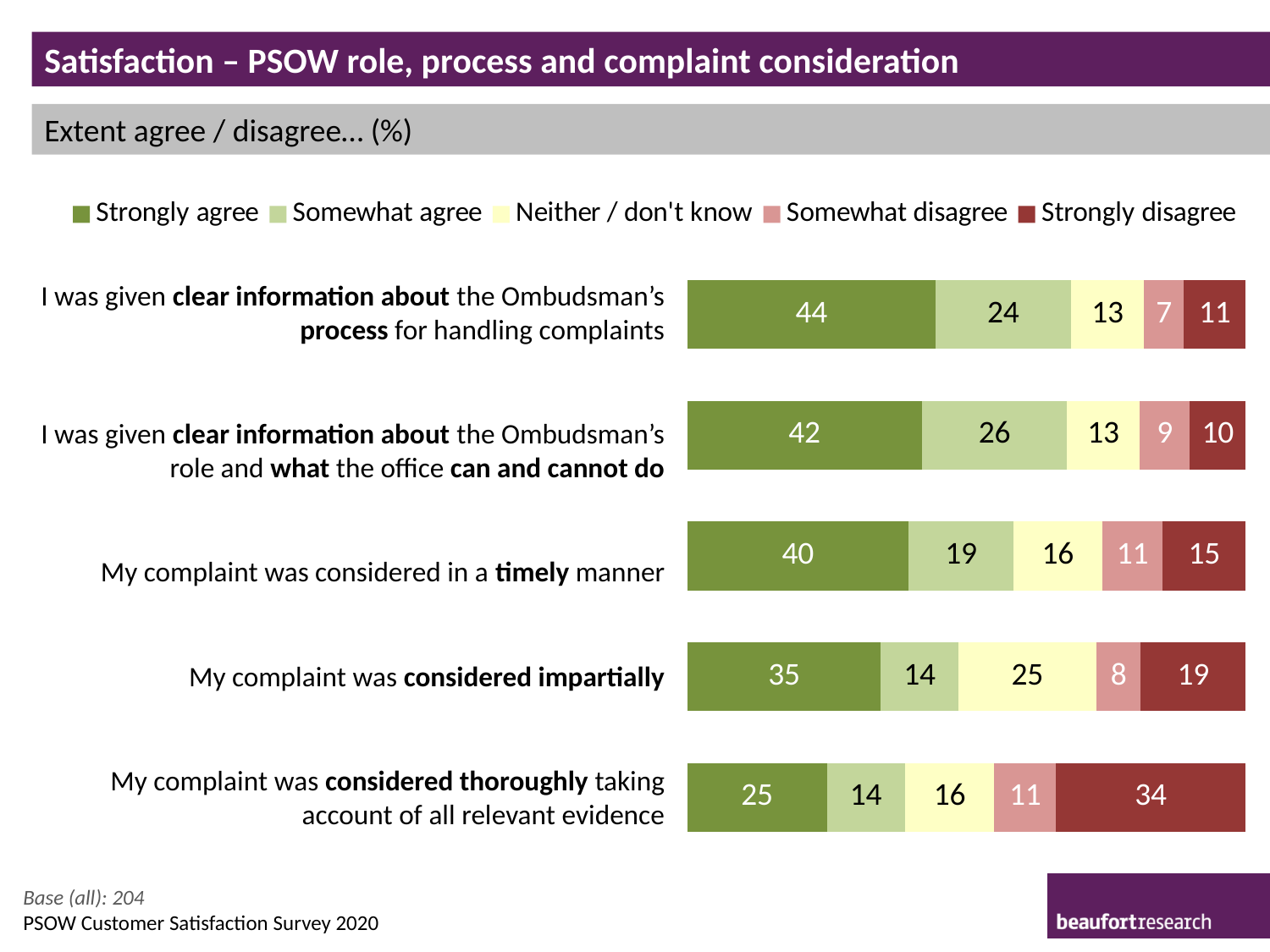
What is the difference between the 'Strongly agree' values for 'clear information about the Ombudsman's process' and 'considered thoroughly'? 19 How many statements (bars) are plotted in the chart? 5 What is the 'Strongly disagree' value for 'My complaint was considered thoroughly taking account of all relevant evidence'? 34 What kind of chart is shown on the slide? Stacked bar chart What is the 'Strongly agree' value for 'My complaint was considered in a timely manner'? 40 How many series does the legend list? 5 What is the 'Somewhat disagree' value for 'I was given clear information about the Ombudsman's role and what the office can and cannot do'? 9 Which statement has the lowest 'Strongly agree' value? My complaint was considered thoroughly taking account of all relevant evidence What is the total of the stacked bar for 'I was given clear information about the Ombudsman's role and what the office can and cannot do'? 100 Which has the larger 'Neither / don't know' value: 'My complaint was considered impartially' or 'My complaint was considered in a timely manner'? My complaint was considered impartially Which statement has the highest 'Strongly disagree' value? My complaint was considered thoroughly taking account of all relevant evidence Which statement has the highest 'Strongly agree' value? I was given clear information about the Ombudsman's process for handling complaints